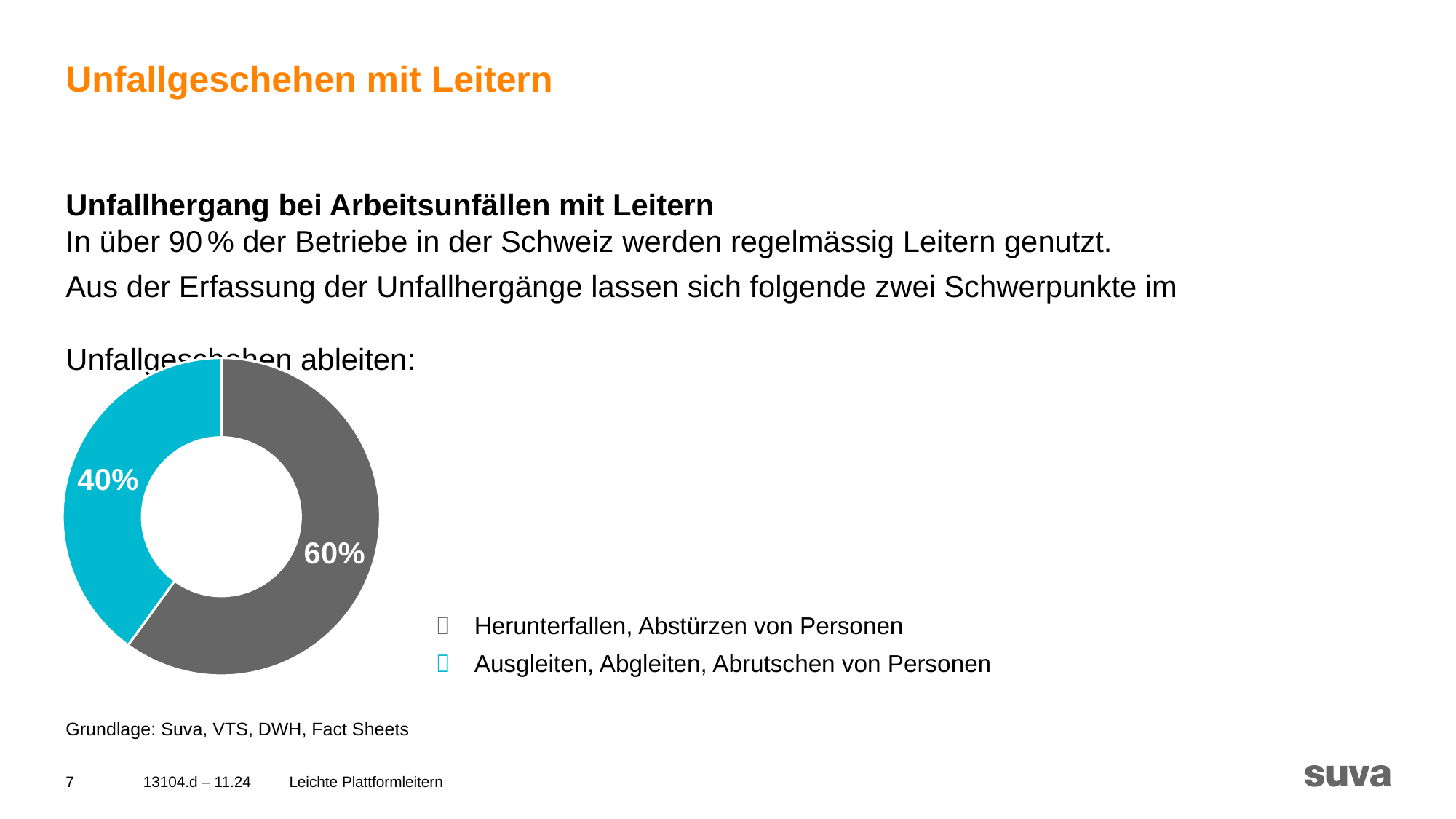
What share of the pie chart is labelled for "Herunterfallen, Abstürzen von Personen"? 60% What kind of chart is shown on the slide? Pie chart (donut) What is the difference in percentage points between the two slices of the pie chart? 20 percentage points What is the total of the two slice percentages shown in the pie chart? 100% What colour is the slice for "Herunterfallen, Abstürzen von Personen"? Grey Which is larger: the slice for "Herunterfallen, Abstürzen von Personen" or the slice for "Ausgleiten, Abgleiten, Abrutschen von Personen"? Herunterfallen, Abstürzen von Personen What share of the pie chart is labelled for "Ausgleiten, Abgleiten, Abrutschen von Personen"? 40% How many entries does the legend of the pie chart list? 2 What colour is the slice for "Ausgleiten, Abgleiten, Abrutschen von Personen"? Cyan (light blue) How many slices does the pie chart have? 2 Which category has the largest slice in the pie chart? Herunterfallen, Abstürzen von Personen Which category has the smallest slice in the pie chart? Ausgleiten, Abgleiten, Abrutschen von Personen